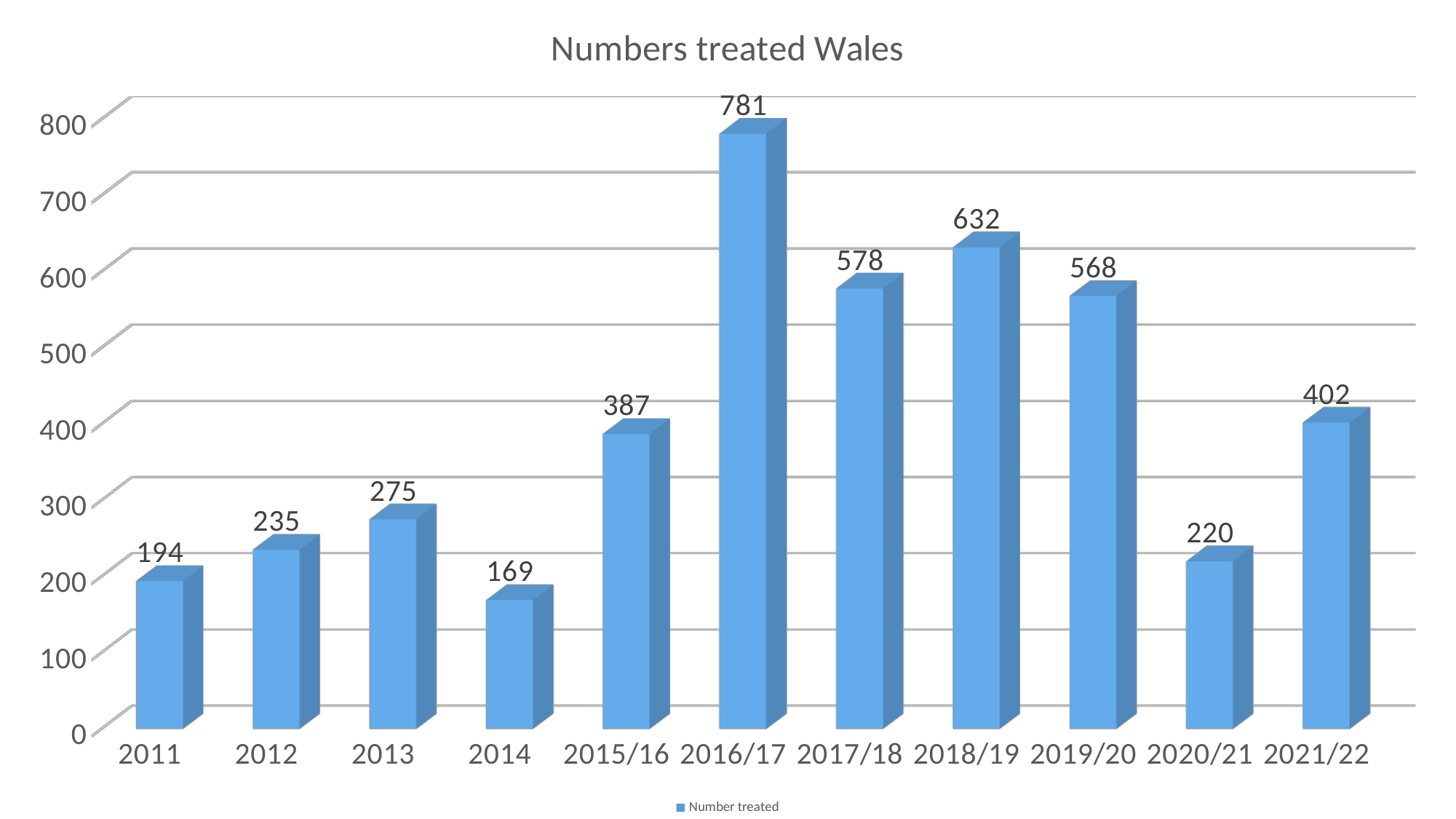
How many series does the legend list? 1 What is the title of the chart? Numbers treated Wales What kind of chart is shown on the slide? bar chart What is the number treated in 2021/22? 402 What is the number treated in 2016/17? 781 Is the value for 2015/16 greater or less than 300? greater Which is larger, the number treated in 2012 or in 2020/21? 2012 What is the number treated in 2014? 169 How many categories are shown on the x axis? 11 Which year has the lowest number treated? 2014 What is the difference between the number treated in 2018/19 and 2019/20? 64 Which year has the highest number treated? 2016/17